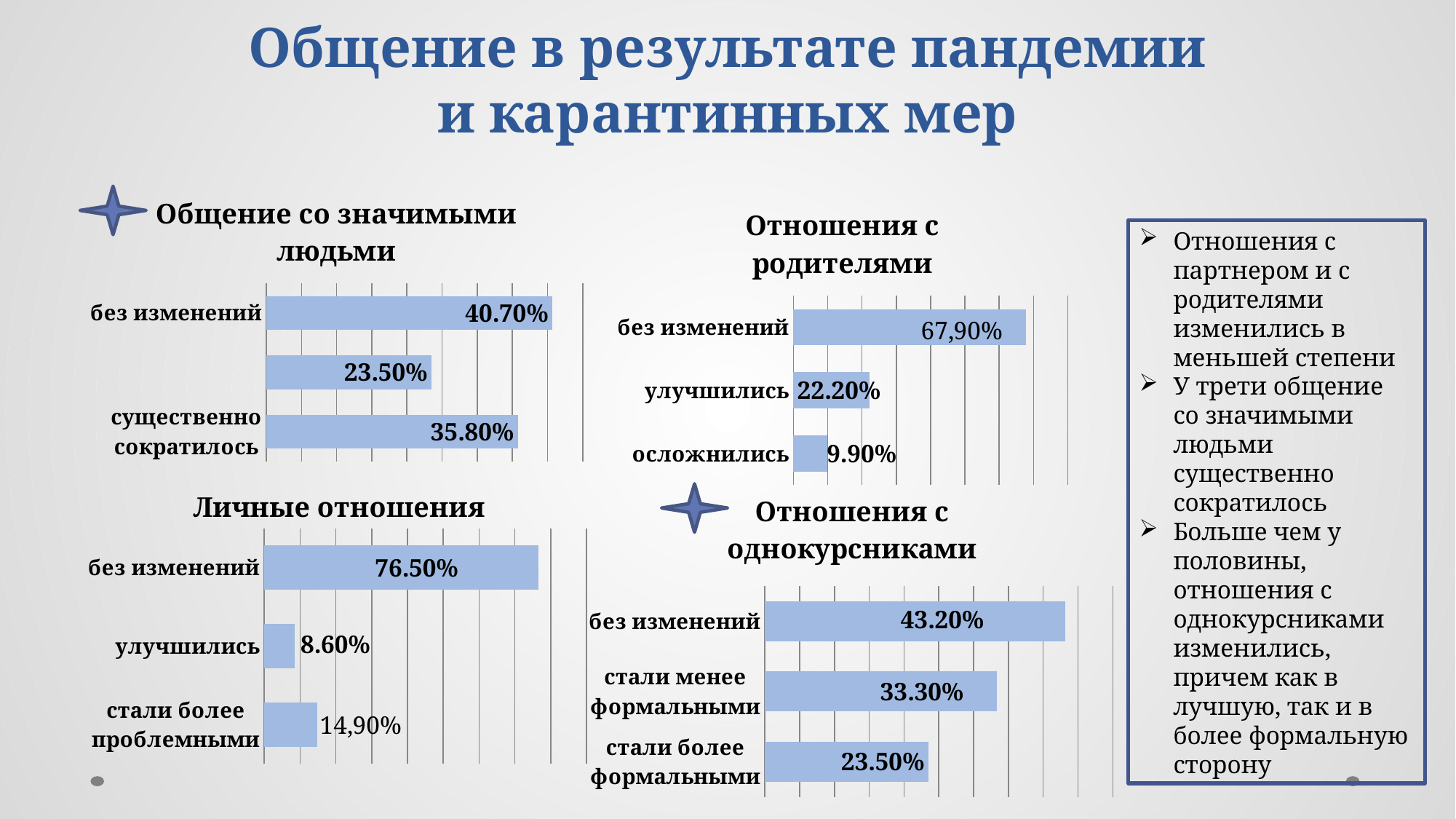
In the chart titled "Отношения с родителями", which category has the lowest value? осложнились In the chart titled "Отношения с однокурсниками", how many categories are shown? 3 In the chart titled "Личные отношения", what is the difference between "без изменений" and "улучшились"? 67.90% In the chart titled "Личные отношения", which is larger: "стали более проблемными" or "улучшились"? стали более проблемными In the chart titled "Общение со значимыми людьми", what is the value for "существенно сократилось"? 35.80% In the chart titled "Отношения с однокурсниками", what is the value for "стали менее формальными"? 33.30% In the chart titled "Отношения с родителями", what is the value for "без изменений"? 67,90% In the chart titled "Отношения с однокурсниками", what is the difference between "без изменений" and "стали более формальными"? 19.70% What type of chart is the chart titled "Отношения с родителями"? bar chart In the chart titled "Личные отношения", what is the value for "улучшились"? 8.60% In the chart titled "Общение со значимыми людьми", which category has the highest value? без изменений How many charts are shown on the slide? 4